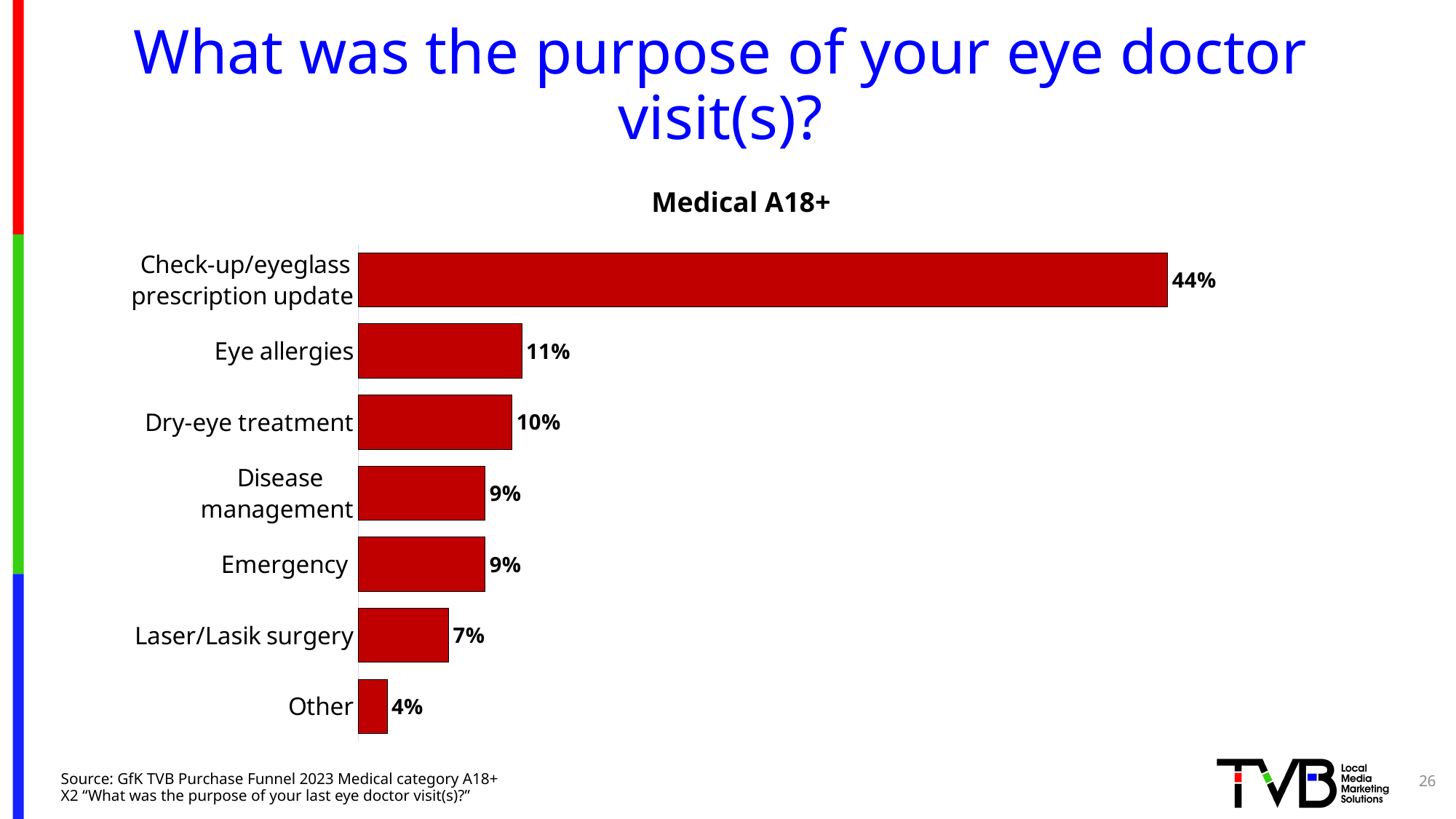
What is the value for Laser/Lasik surgery? 7% What is the value for Eye allergies? 11% What is the difference between the values for Check-up/eyeglass prescription update and Eye allergies? 33% Which is larger, the value for Eye allergies or the value for Dry-eye treatment? Eye allergies How many categories are shown in the chart? 7 What is the difference between Dry-eye treatment and Other? 6% What is the title shown above the chart? Medical A18+ Which purpose of eye doctor visit has the highest percentage? Check-up/eyeglass prescription update What kind of chart is shown on the slide? Bar chart What colour are the bars in the chart? Red What percentage of respondents visited the eye doctor for a check-up/eyeglass prescription update? 44% Which category has the lowest percentage? Other